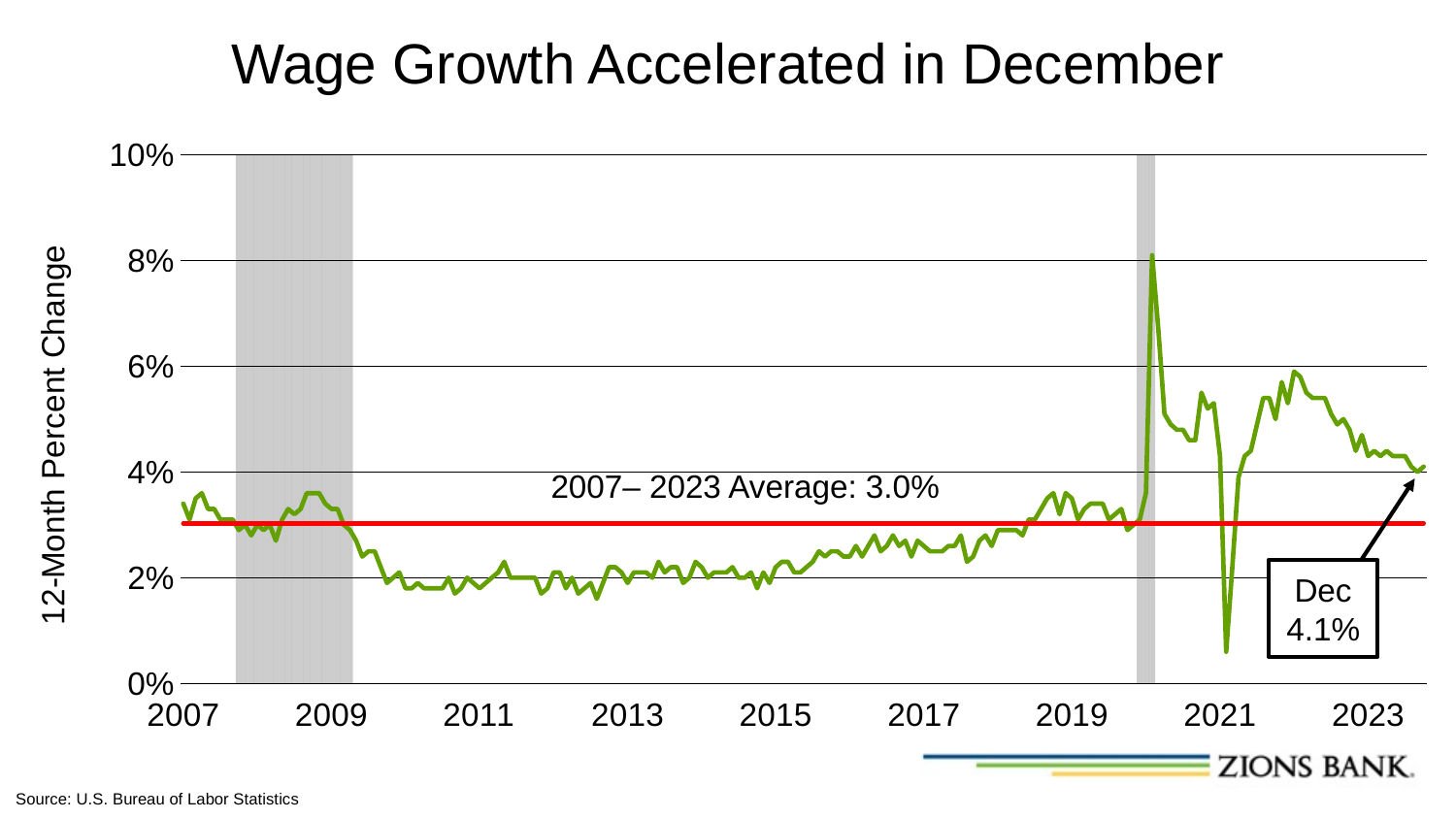
What source is cited for the chart data? U.S. Bureau of Labor Statistics Is the lowest value of the green line in 2020 greater or less than 2%? greater Is the peak value of the green line in 2022 greater or less than 4%? greater Is the peak value of the green line in 2020 greater or less than 6%? greater How many year labels are shown on the x axis? 9 What is the 12-month percent change in wages labeled for December? 4.1% What is the title of the chart? Wage Growth Accelerated in December What kind of chart is shown on the slide? line chart By how much does the December value (4.1%) exceed the 2007–2023 average (3.0%)? 1.1 percentage points Do the values of the green line rise or fall from the 2022 peak to the end of 2023? fall What is the 2007–2023 average 12-month percent change shown by the red line? 3.0% Which is larger, the December value or the 2007–2023 average? the December value